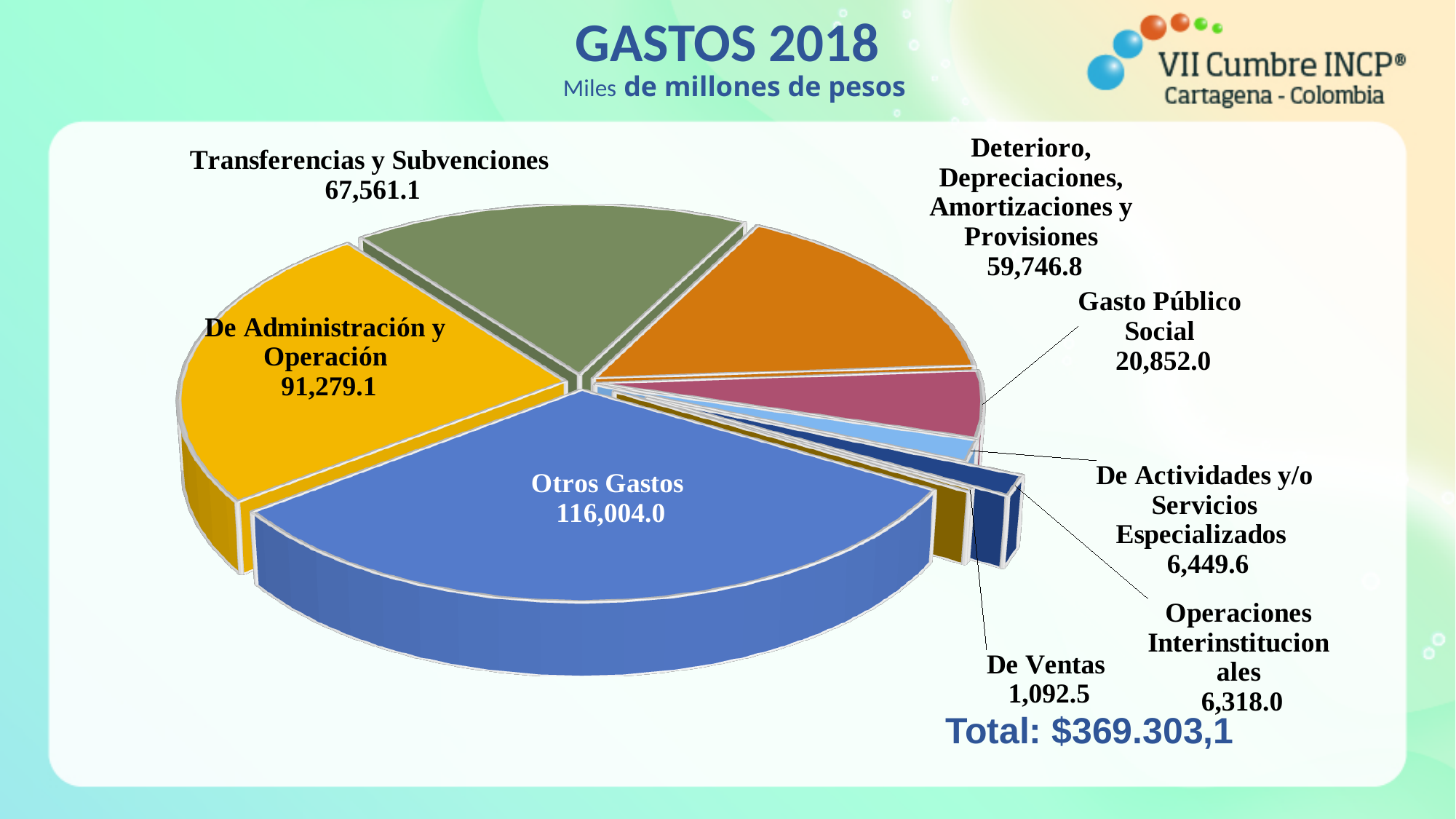
What is the value for Otros Gastos? 116,004.0 What is the value for De Administración y Operación? 91,279.1 What is the value for Gasto Público Social? 20,852.0 In what units are the values on the chart expressed, according to the subtitle? Miles de millones de pesos What is the value for De Ventas? 1,092.5 Which category has the largest value? Otros Gastos What is the difference between Otros Gastos and De Administración y Operación? 24,724.9 Which category has the smallest value? De Ventas Which is larger, Transferencias y Subvenciones or Deterioro, Depreciaciones, Amortizaciones y Provisiones? Transferencias y Subvenciones How many categories are shown in the pie chart? 8 What kind of chart is shown on the slide? Pie chart What total is printed on the slide for the chart? $369.303,1